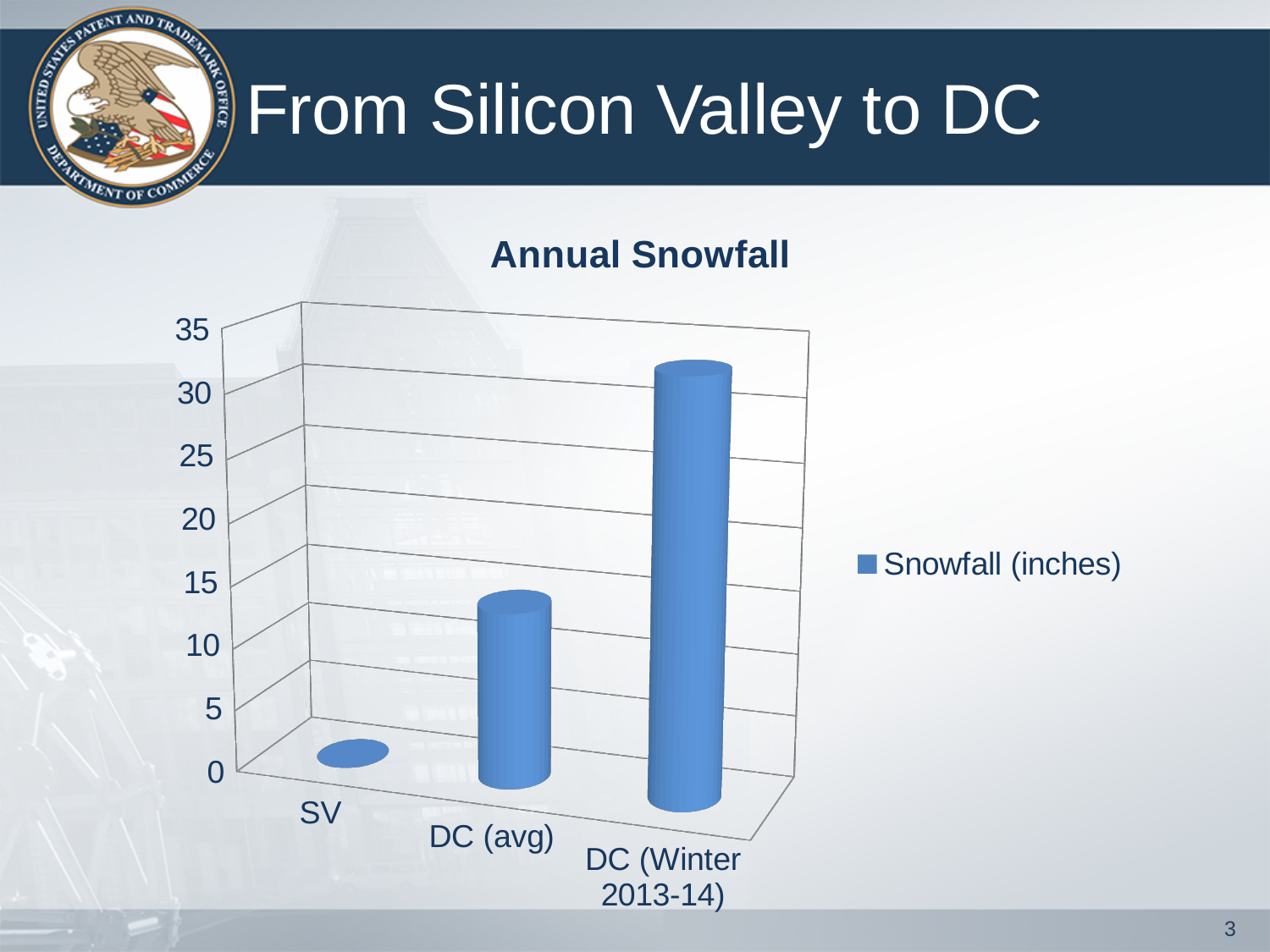
Which is larger, the snowfall for DC (avg) or for DC (Winter 2013-14)? DC (Winter 2013-14) What is the title of the chart? Annual Snowfall Which category has the lowest snowfall in the chart? SV Is the snowfall value for DC (avg) greater or less than 5? greater How many categories are shown on the x axis of the chart? 3 Is the snowfall value for SV greater or less than 5? less Do the snowfall values rise or fall moving from left to right along the x axis? rise Which category has the highest snowfall in the chart? DC (Winter 2013-14) What kind of chart is shown on the slide? bar chart What series name is shown in the chart's legend? Snowfall (inches) Is the snowfall value for DC (Winter 2013-14) greater or less than 25? greater How many series does the chart's legend list? 1